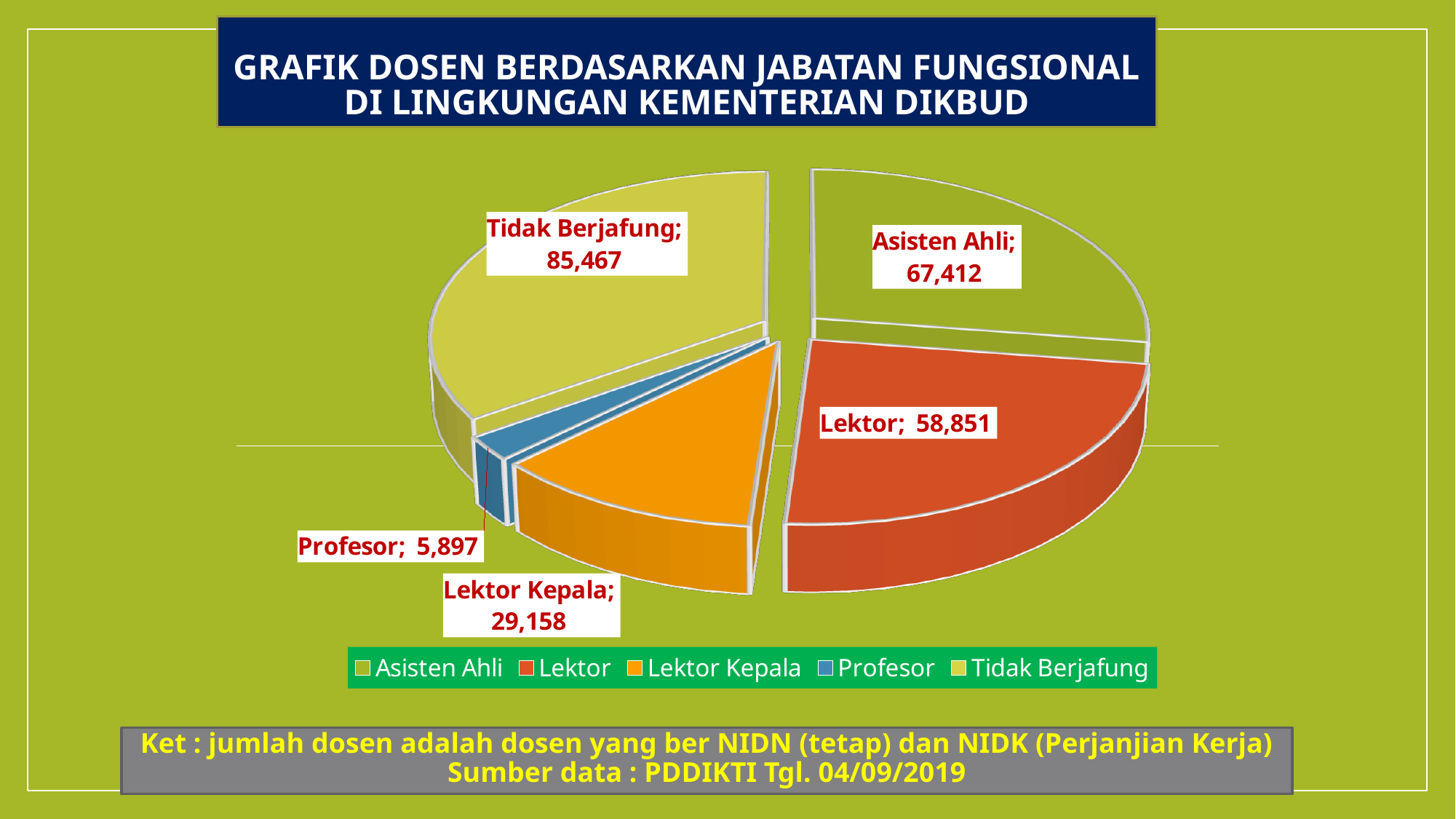
What is the value shown for Lektor Kepala? 29,158 What is the difference between the Tidak Berjafung and Asisten Ahli values? 18,055 How many categories are shown in the pie chart? 5 What is the value shown for Asisten Ahli? 67,412 How many dosen are in the Tidak Berjafung category? 85,467 What colour is the Lektor slice in the pie chart? Red-orange What is the value shown for Profesor? 5,897 What kind of chart is shown on the slide? Pie chart Which category has the smallest slice of the pie? Profesor What is the difference between the Lektor Kepala and Profesor values? 23,261 Which is larger, the value for Asisten Ahli or the value for Lektor? Asisten Ahli Which category has the largest slice of the pie? Tidak Berjafung